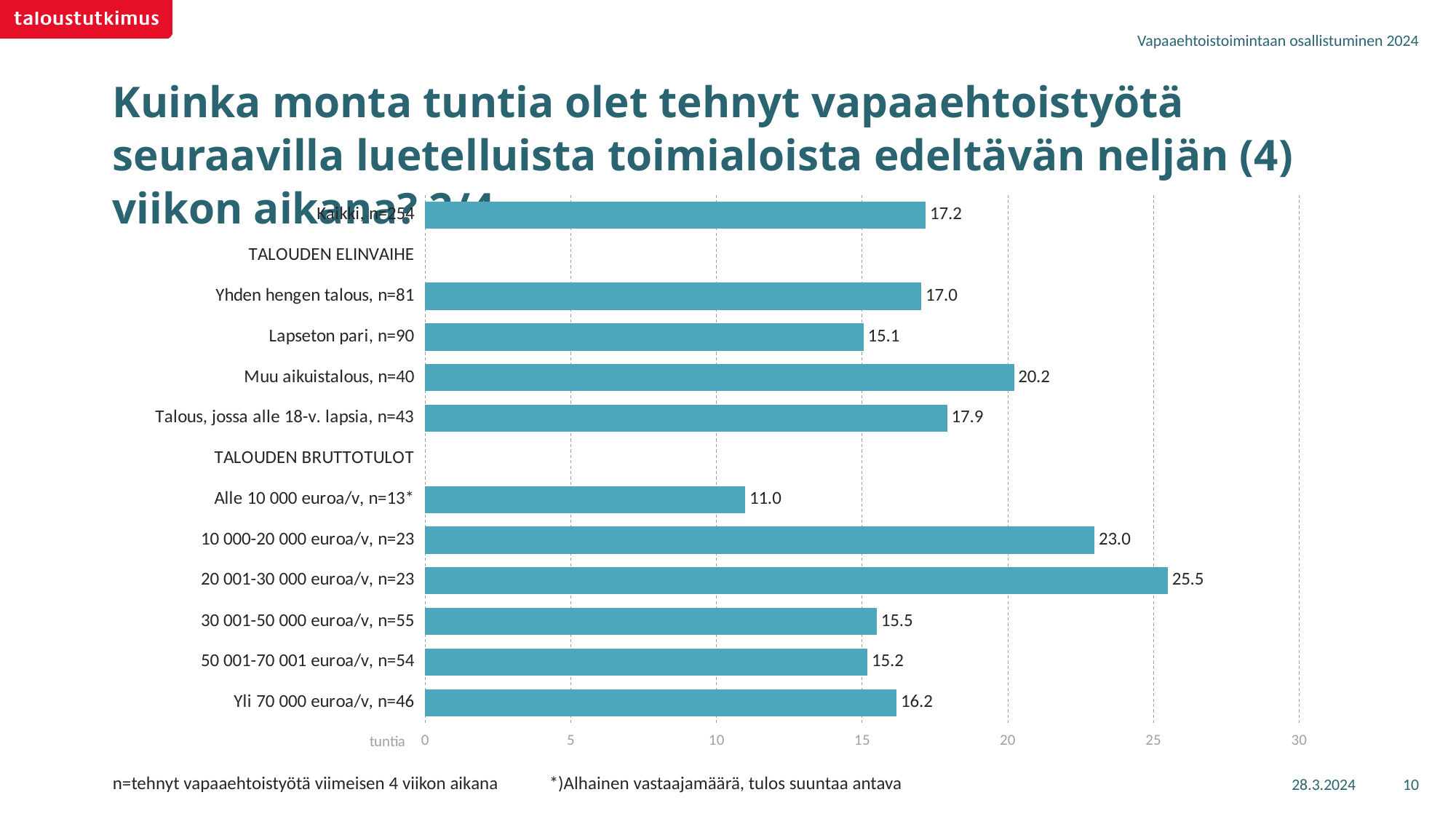
What is the difference between the values for Muu aikuistalous, n=40 and Talous, jossa alle 18-v. lapsia, n=43? 2.3 Which category has the highest value? 20 001-30 000 euroa/v, n=23 What is the value for 10 000-20 000 euroa/v, n=23? 23.0 What is the highest tick value shown on the horizontal axis? 30 What is the difference between the values for 20 001-30 000 euroa/v, n=23 and Alle 10 000 euroa/v, n=13*? 14.5 Is the value for 30 001-50 000 euroa/v, n=55 greater or less than 20? less What kind of chart is shown on the slide? bar chart What is the value for Muu aikuistalous, n=40? 20.2 What is the value for Yli 70 000 euroa/v, n=46? 16.2 Which category has the lowest value? Alle 10 000 euroa/v, n=13* Which has a larger value, Lapseton pari, n=90 or Yhden hengen talous, n=81? Yhden hengen talous, n=81 What is the label of the horizontal axis? tuntia